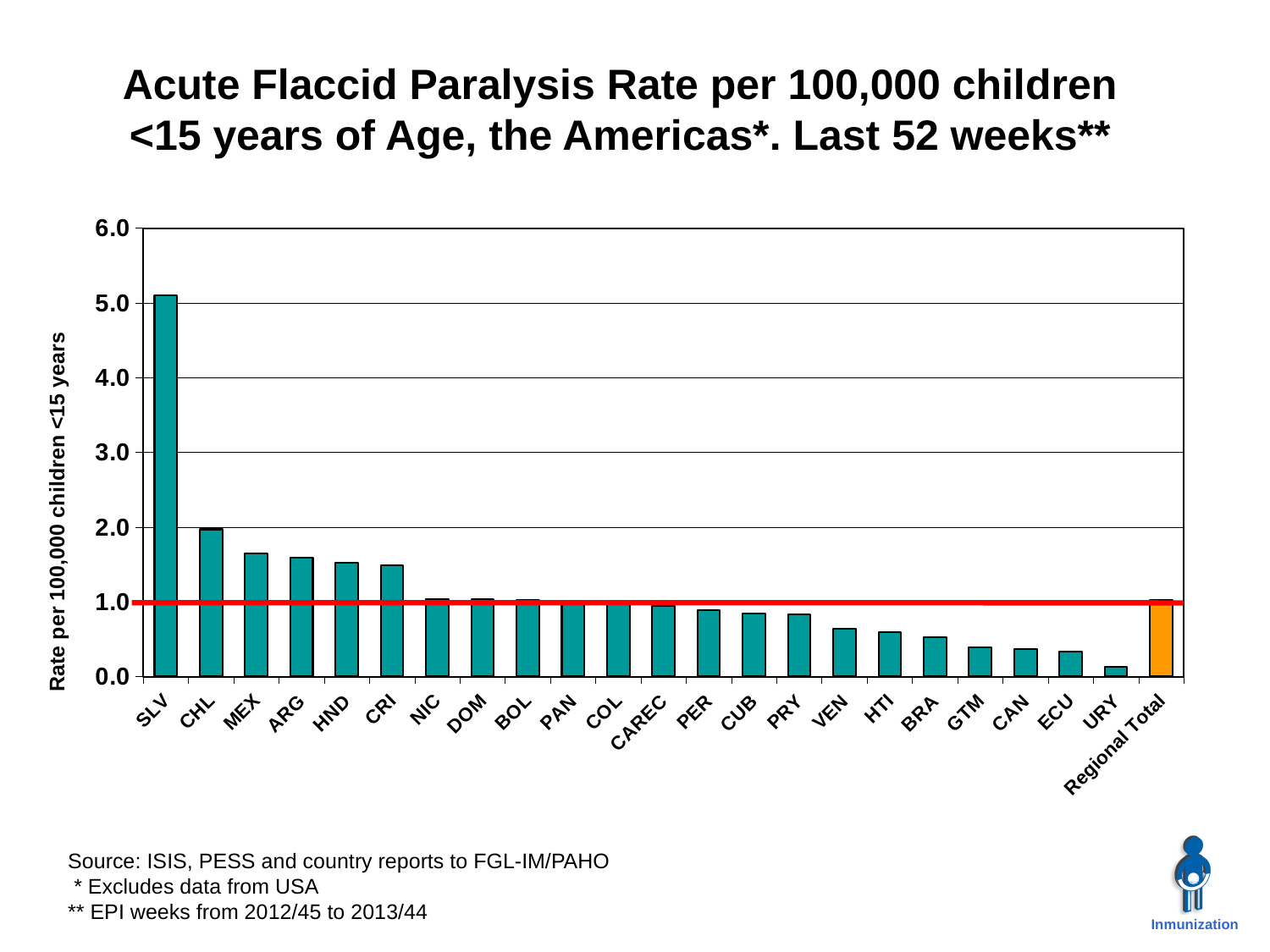
Is the value for MEX greater or less than 1.0? greater Is the value for SLV greater or less than 4.0? greater Which category has the lowest AFP rate? URY How many categories (bars) are plotted on the x axis? 23 Which category has the highest AFP rate? SLV At what value on the y axis is the horizontal red line drawn? 1.0 What kind of chart is shown on the slide? bar chart Is the value for HTI greater or less than 1.0? less Do the country bars rise or fall from left to right along the x axis? fall Which has a higher AFP rate, VEN or ECU? VEN Which has a higher AFP rate, SLV or CHL? SLV